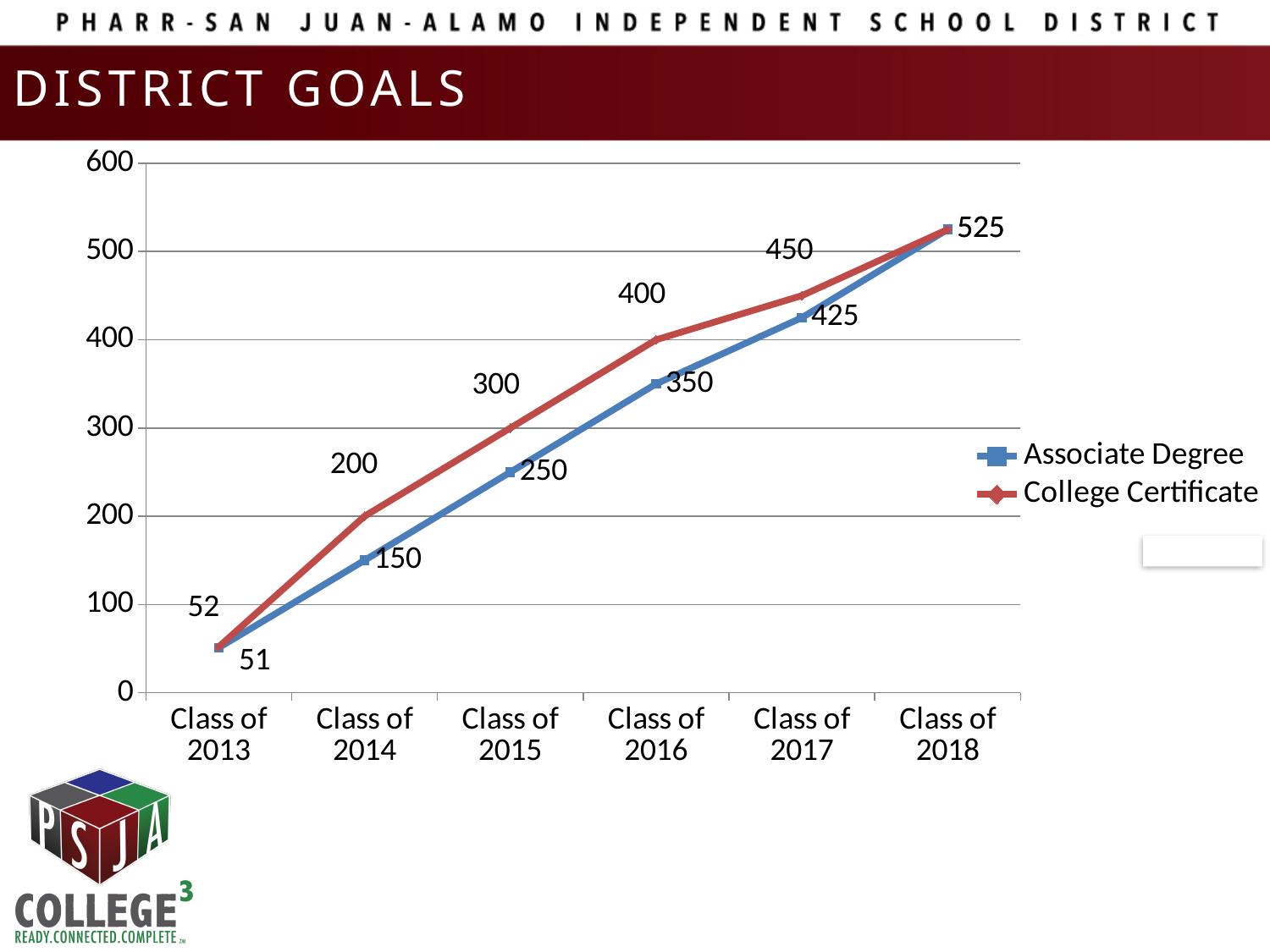
What kind of chart is shown on the slide? Line chart What is the Associate Degree value for the Class of 2017? 425 Which class has the lowest Associate Degree value? Class of 2013 What is the College Certificate value for the Class of 2016? 400 What is the difference between the College Certificate and Associate Degree values for the Class of 2015? 50 What is the Associate Degree value for the Class of 2014? 150 What is the College Certificate value for the Class of 2013? 52 Do the Associate Degree values rise or fall from the Class of 2013 to the Class of 2018? Rise How many classes are shown along the x axis? 6 Which series is drawn in red? College Certificate How many series does the legend list? 2 Which series has the larger value for the Class of 2014, Associate Degree or College Certificate? College Certificate